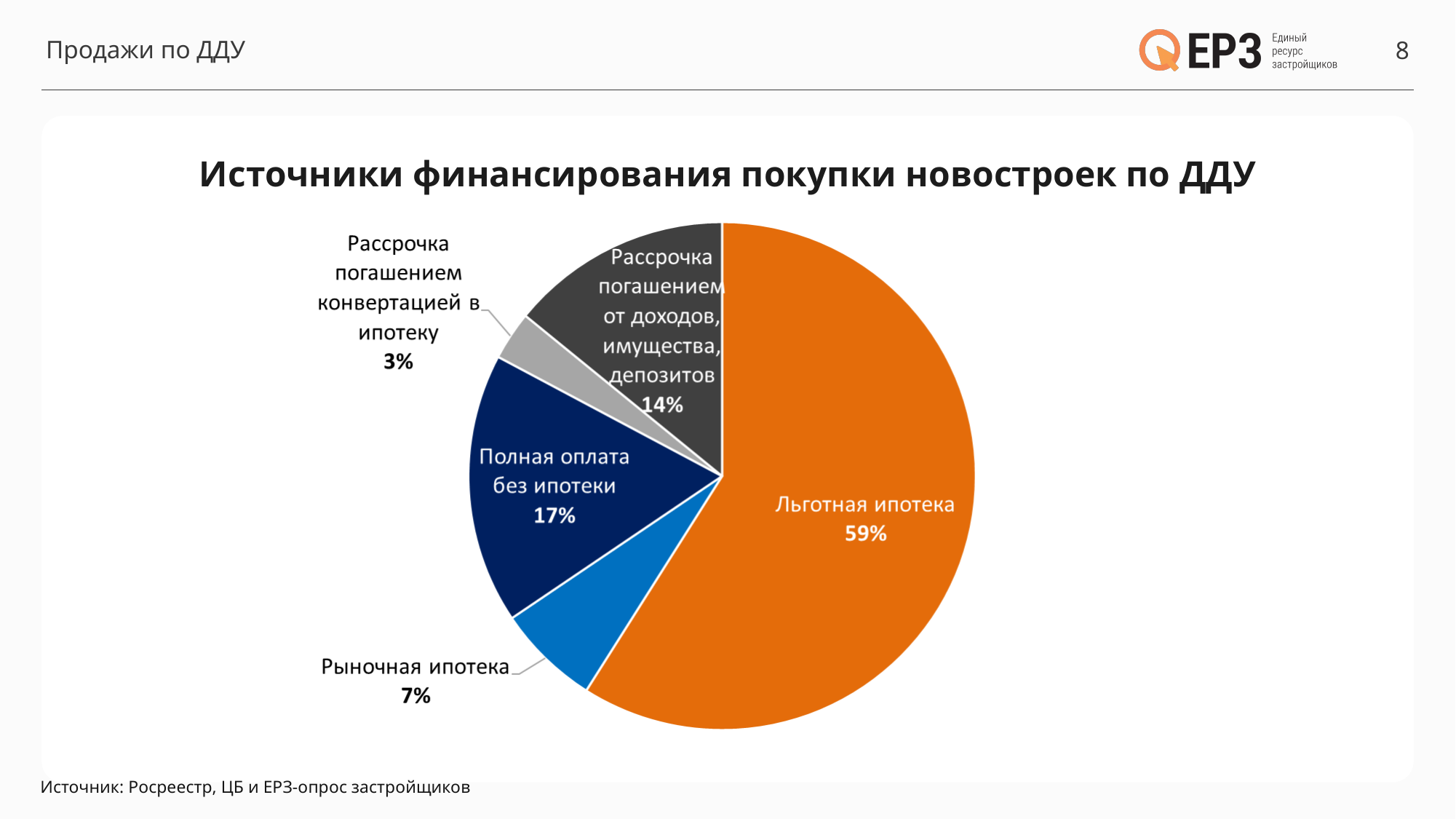
What is the value shown for Рассрочка погашением конвертацией в ипотеку? 3% Which category has the largest share of the pie? Льготная ипотека Which category has the smallest share of the pie? Рассрочка погашением конвертацией в ипотеку What is the difference in percentage points between Льготная ипотека and Полная оплата без ипотеки? 42 How many slices does the pie chart have? 5 What is the value shown for Полная оплата без ипотеки? 17% What is the value shown for Рыночная ипотека? 7% Which is larger: Полная оплата без ипотеки or Рассрочка погашением от доходов, имущества, депозитов? Полная оплата без ипотеки What kind of chart is shown on the slide? Pie chart What share of the pie does Льготная ипотека hold? 59% What is the value shown for Рассрочка погашением от доходов, имущества, депозитов? 14% What is the title of the chart? Источники финансирования покупки новостроек по ДДУ